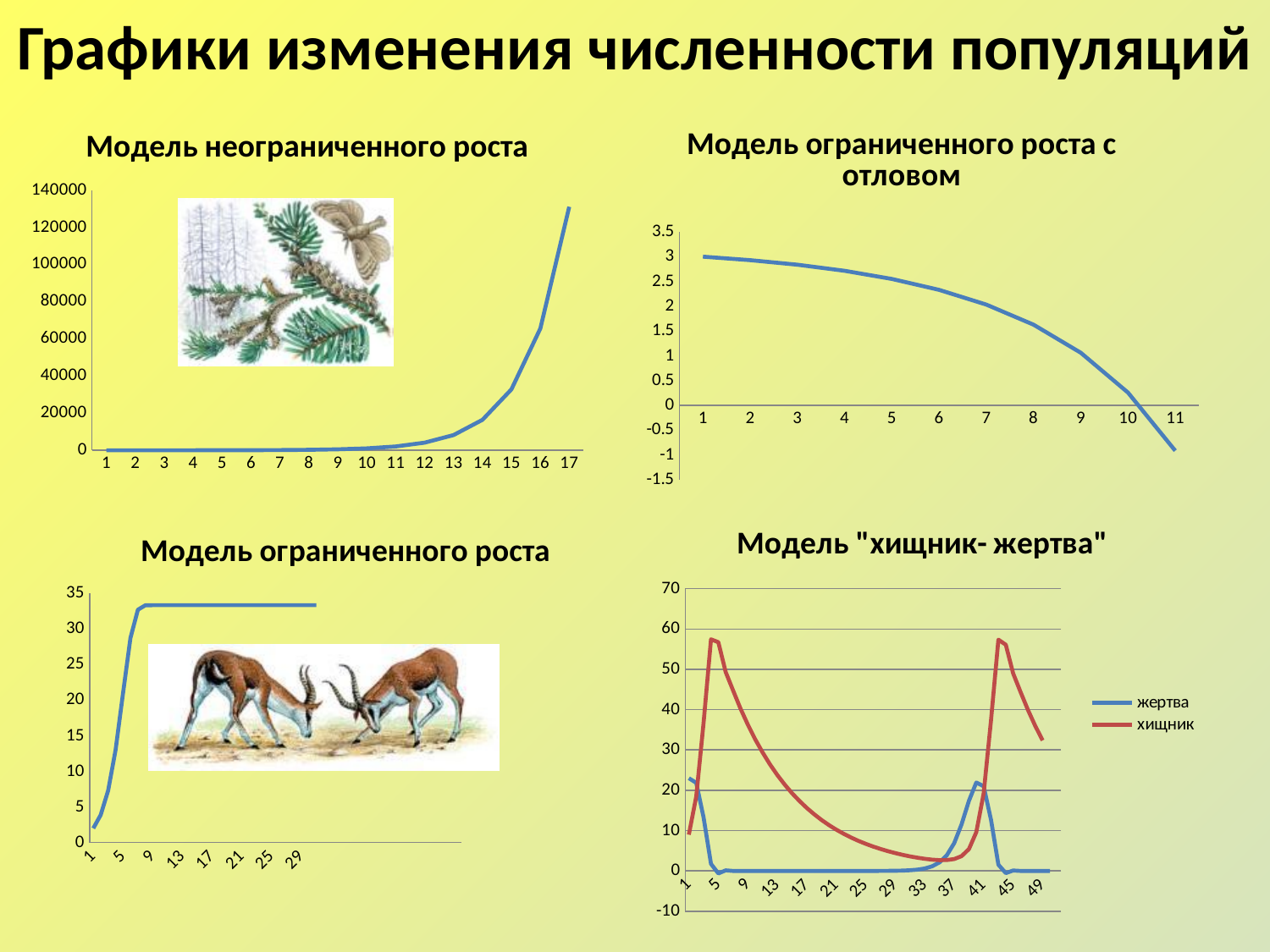
In the chart "Модель ограниченного роста с отловом", do the values rise or fall along the x axis? fall In the chart "Модель "хищник- жертва"", is the peak value of the хищник series greater or less than 50? greater In the chart "Модель неограниченного роста", is the value at x = 13 greater or less than 20000? less How many series does the legend list in the chart "Модель "хищник- жертва""? 2 In the chart "Модель "хищник- жертва"", which colour represents the жертва series? blue In the chart "Модель ограниченного роста" (bottom left), is the plateau value reached after x = 9 greater or less than 30? greater In the chart "Модель неограниченного роста", do the values rise or fall along the x axis? rise How many x-axis points are labelled in the chart "Модель неограниченного роста"? 17 What type of chart is "Модель неограниченного роста"? line chart